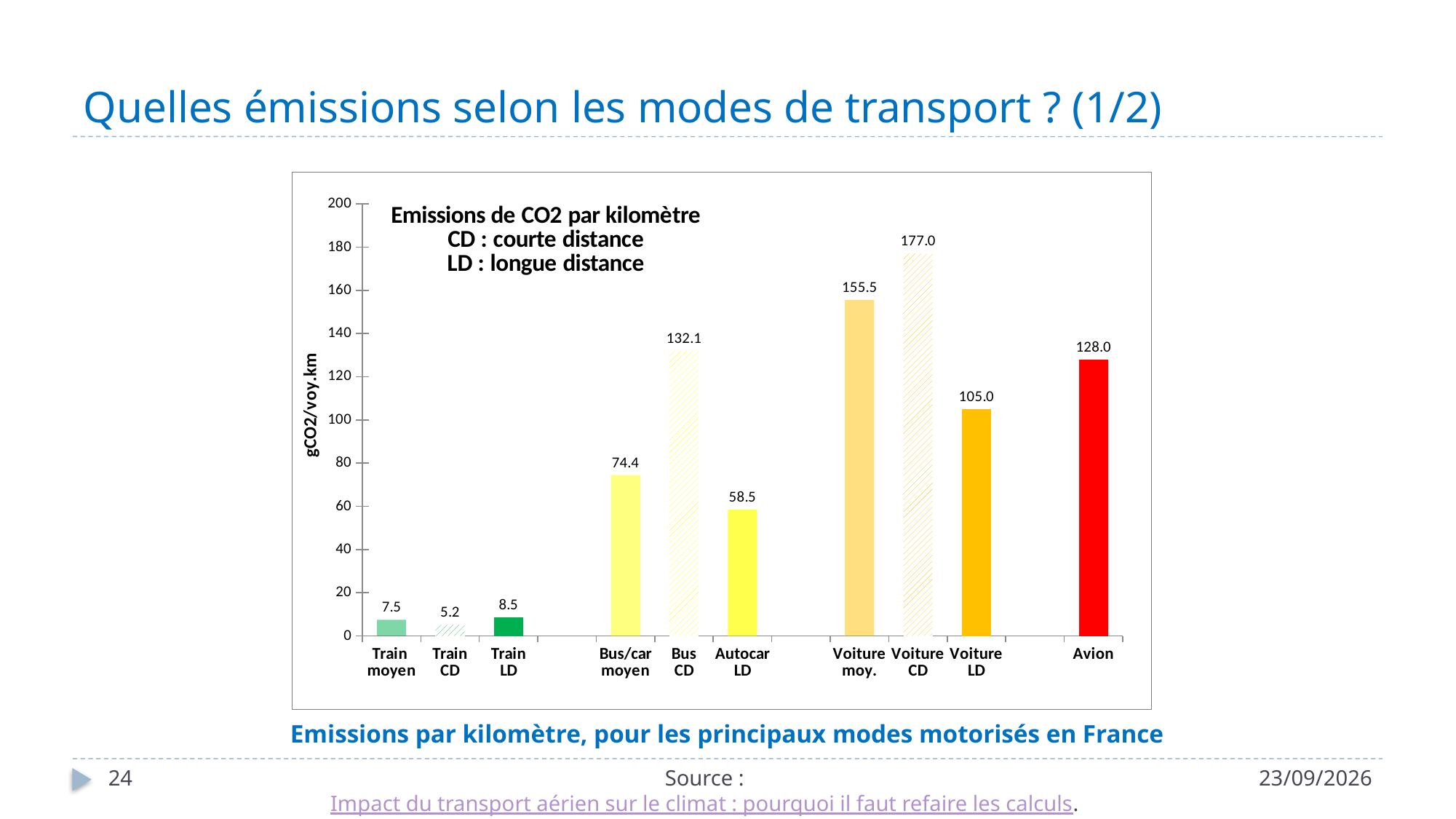
Which is larger, Avion or Voiture LD? Avion What is the label of the y axis? gCO2/voy.km What is the value for Avion? 128.0 Which category has the lowest value? Train CD What is the value for Train CD? 5.2 What kind of chart is this? bar chart Which category has the highest value? Voiture CD How many categories are shown on the x axis? 10 What is the difference between Voiture moy. and Voiture LD? 50.5 What is the value for Voiture CD? 177.0 What is the value for Bus/car moyen? 74.4 What is the difference between Bus CD and Autocar LD? 73.6